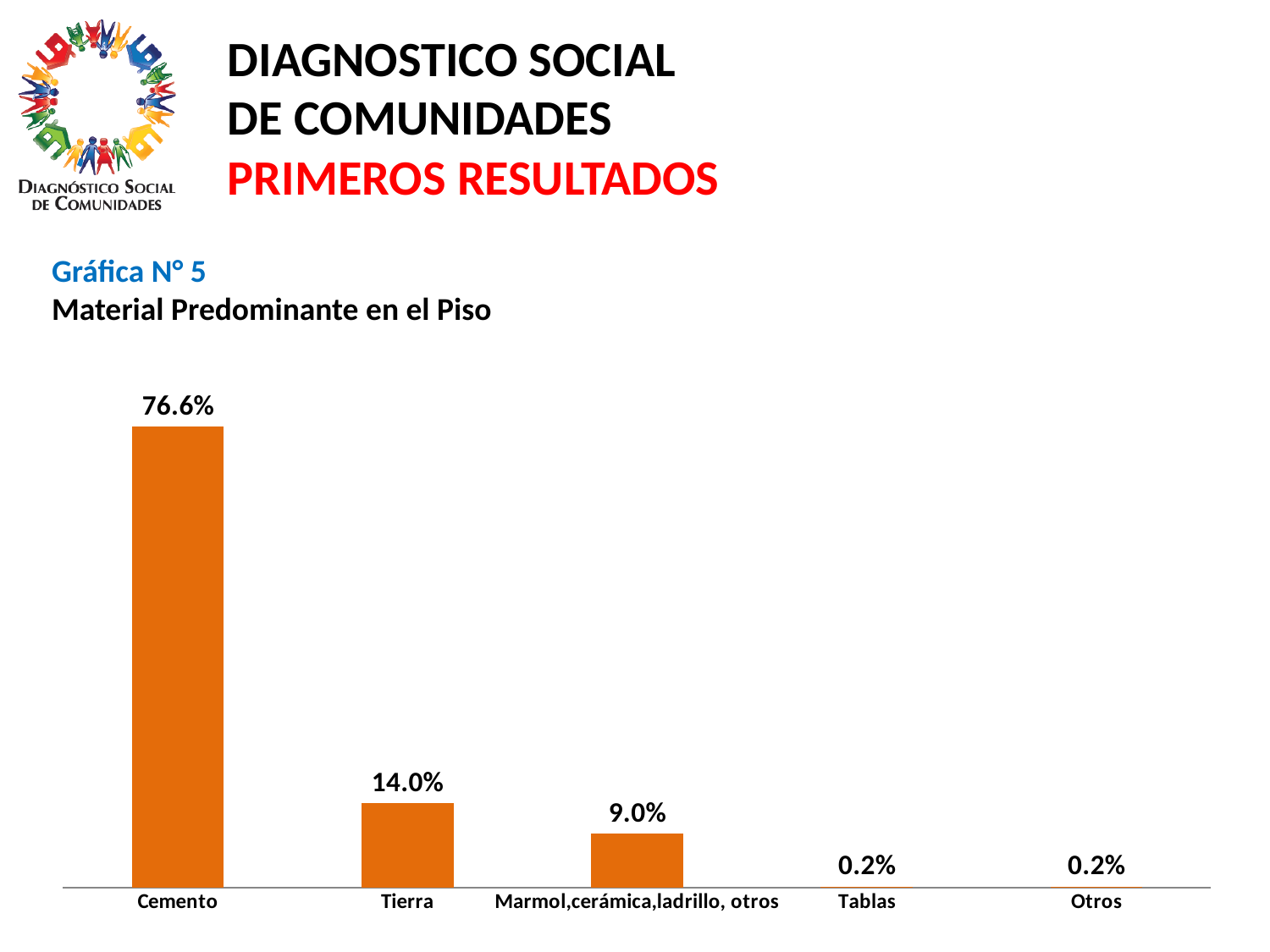
How many categories are shown on the x axis? 5 What is the difference between the values for Cemento and Tierra? 62.6% Which is larger, the value for Tierra or the value for Marmol,cerámica,ladrillo, otros? Tierra Which category has the highest value? Cemento What is the value for Marmol,cerámica,ladrillo, otros? 9.0% What is the title of the chart? Material Predominante en el Piso What is the difference between the values for Tierra and Marmol,cerámica,ladrillo, otros? 5.0% Do the values rise or fall from Cemento to Marmol,cerámica,ladrillo, otros along the x axis? Fall What is the value for Tierra? 14.0% What is the value for Tablas? 0.2% What kind of chart is shown on the slide? Bar chart What is the value for Cemento? 76.6%